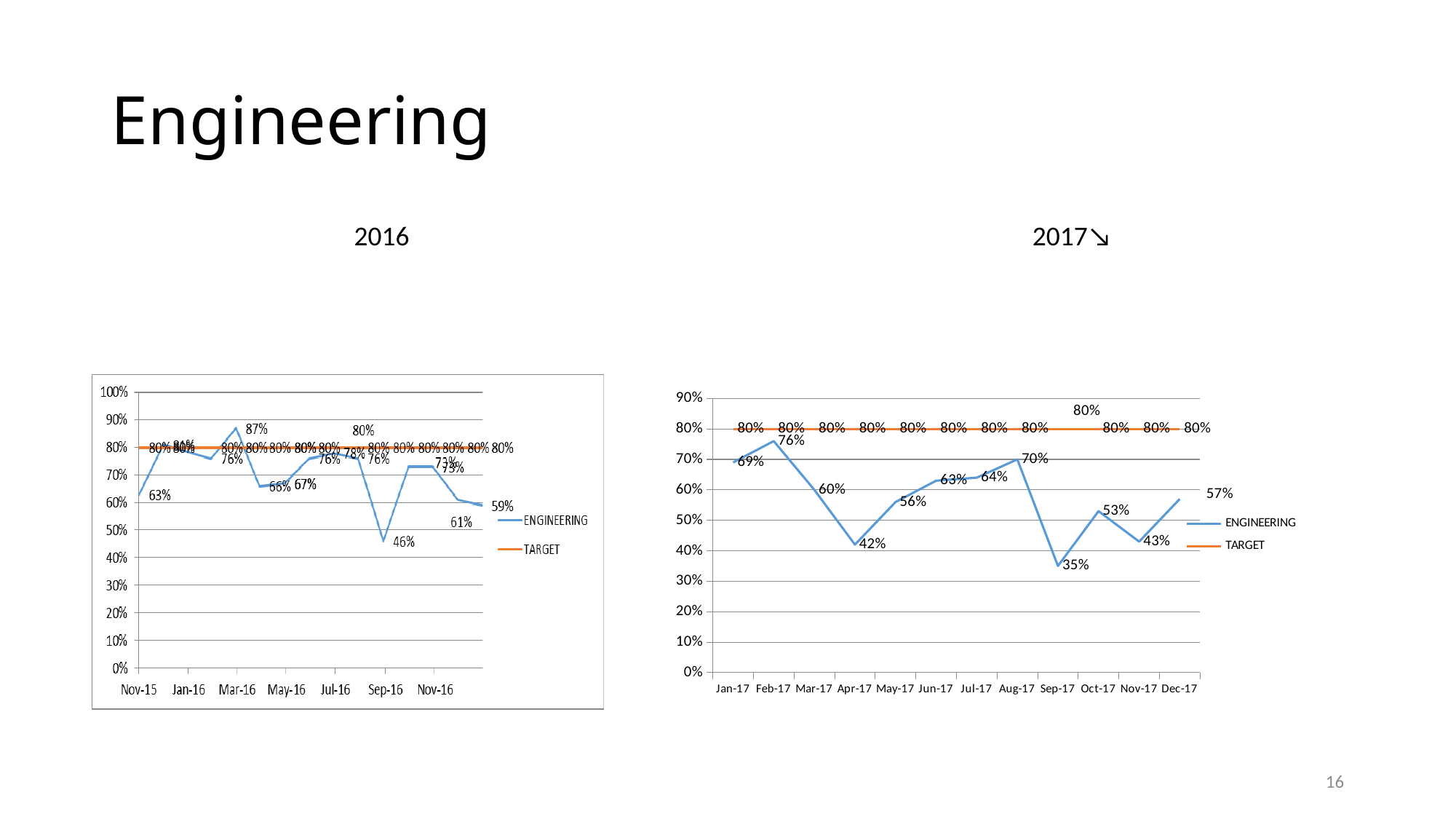
In the 2017 chart, which month has the lowest ENGINEERING value? Sep-17 What type of chart is the 2016 chart? Line chart In the 2017 chart, what is the ENGINEERING value for Sep-17? 35% In the 2017 chart, how many months are plotted on the x axis? 12 In the 2016 chart, what is the ENGINEERING value for Mar-16? 87% In the 2017 chart, how many series does the legend list? 2 In the 2017 chart, which month has the highest ENGINEERING value? Feb-17 In the 2017 chart, is the ENGINEERING value for Aug-17 or Dec-17 larger? Aug-17 In the 2016 chart, what is the lowest ENGINEERING value shown? 46% In the 2017 chart, what is the difference between the TARGET and the ENGINEERING value for Apr-17? 38% In the 2017 chart, what is the ENGINEERING value for Feb-17? 76% In the 2017 chart, what value does the TARGET line hold across all months? 80%